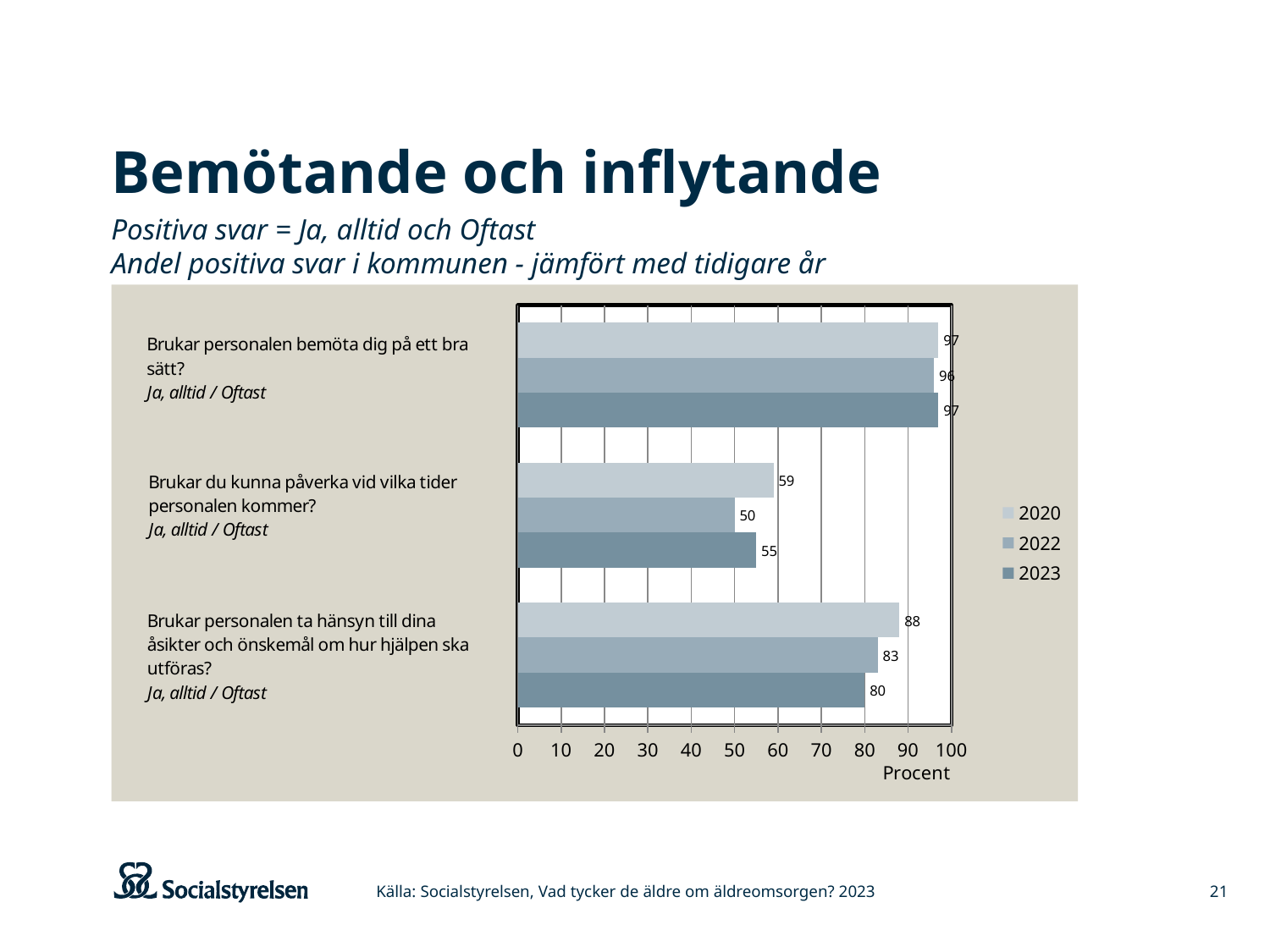
What is the difference between the 2020 and 2022 values for "Brukar du kunna påverka vid vilka tider personalen kommer?"? 9 How many series does the legend list? 3 What is the label on the horizontal axis of the chart? Procent How many questions (categories) are shown on the chart? 3 What is the 2020 value for "Brukar personalen ta hänsyn till dina åsikter och önskemål om hur hjälpen ska utföras?"? 88 For "Brukar personalen ta hänsyn till dina åsikter och önskemål om hur hjälpen ska utföras?", do the values rise or fall from 2020 to 2023? Fall Which question has the lowest 2022 value? Brukar du kunna påverka vid vilka tider personalen kommer? What is the 2023 value for "Brukar du kunna påverka vid vilka tider personalen kommer?"? 55 What kind of chart is shown on the slide? Bar chart For "Brukar personalen ta hänsyn till dina åsikter och önskemål om hur hjälpen ska utföras?", which is larger, the 2020 value or the 2023 value? 2020 Which question has the highest 2023 value? Brukar personalen bemöta dig på ett bra sätt? What is the 2022 value for "Brukar personalen bemöta dig på ett bra sätt?"? 96